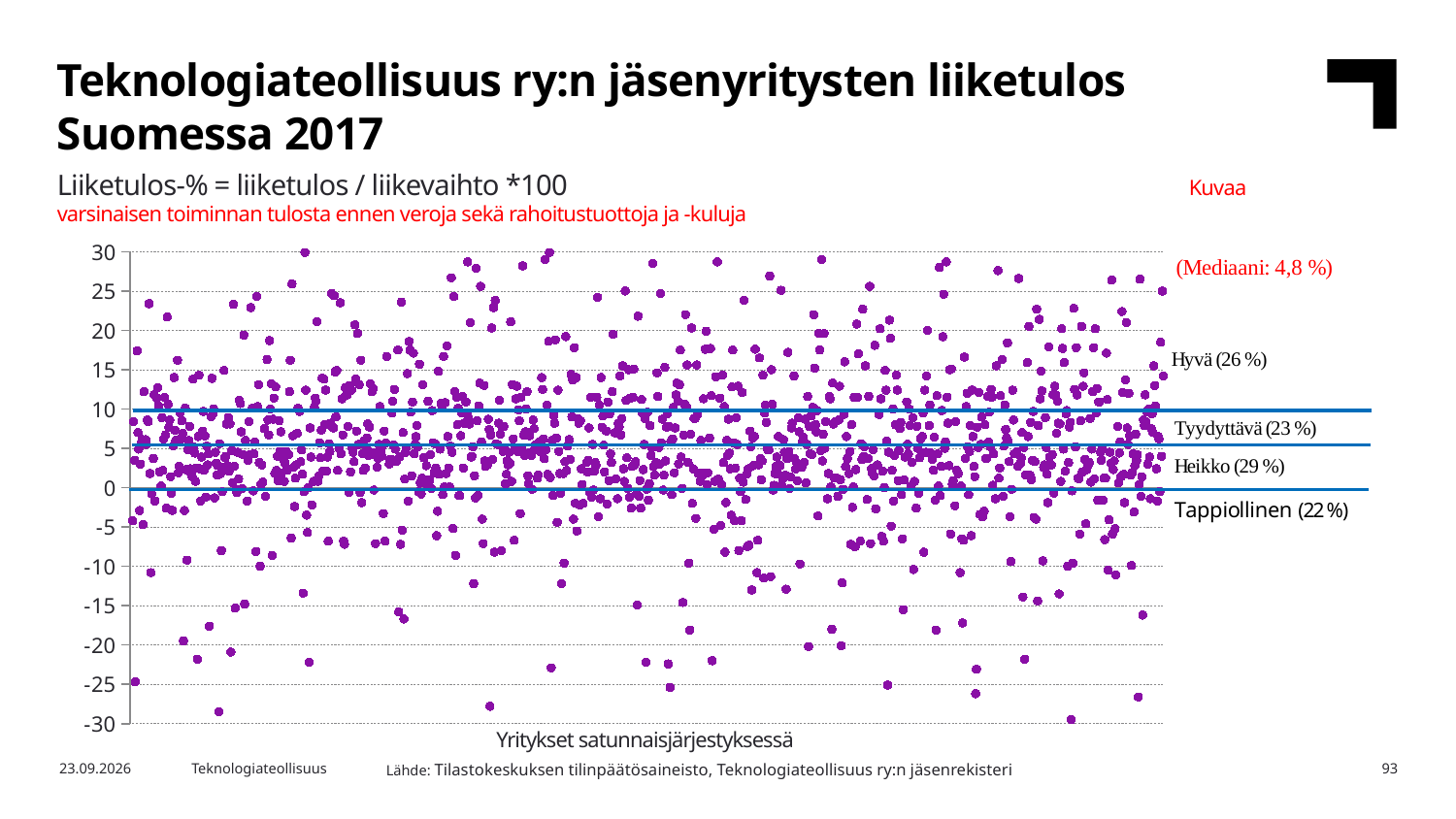
What is the median operating profit percentage (Mediaani) shown on the chart? 4,8 % What is the label of the horizontal axis of the chart? Yritykset satunnaisjärjestyksessä What is the difference in percentage points between the share of 'Heikko' companies and the share of 'Tappiollinen' companies? 7 What percentage of companies fall into the 'Tappiollinen' category according to the chart annotation? 22 % What percentage of companies fall into the 'Heikko' category according to the chart annotation? 29 % What percentage of companies fall into the 'Hyvä' category according to the chart annotation? 26 % Which of the four categories (Hyvä, Tyydyttävä, Heikko, Tappiollinen) has the largest share of companies? Heikko What percentage of companies fall into the 'Tyydyttävä' category according to the chart annotation? 23 % Is the share of 'Hyvä' companies larger or smaller than the share of 'Tyydyttävä' companies? larger Which of the four categories (Hyvä, Tyydyttävä, Heikko, Tappiollinen) has the smallest share of companies? Tappiollinen What is the highest value shown on the vertical axis of the chart? 30 What kind of chart is shown on the slide? scatter chart